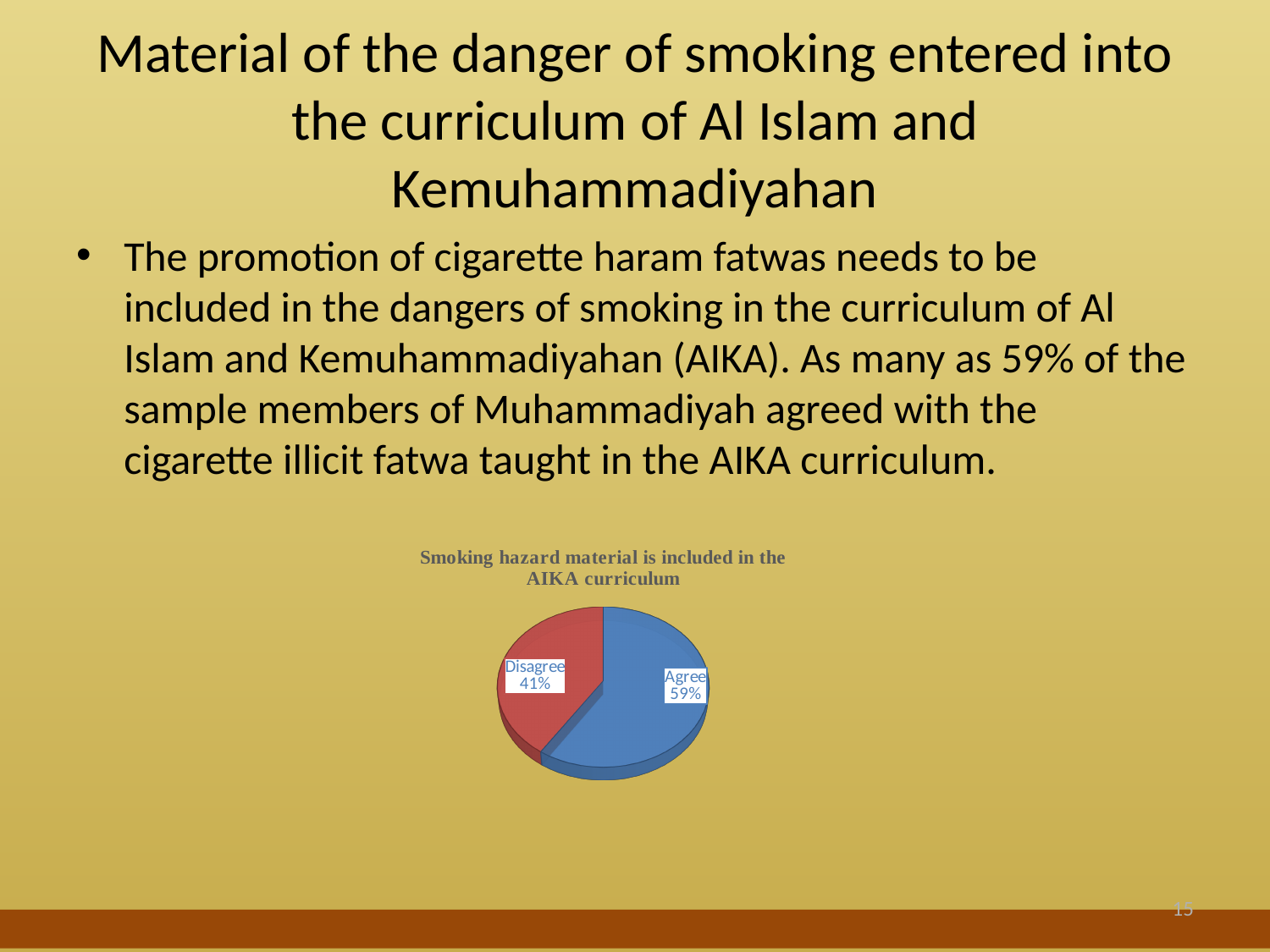
What share of the pie does Disagree represent? 41% What kind of chart is shown on the slide? Pie chart What share of the pie does Agree represent? 59% Which slice of the pie is the smallest? Disagree What is the title of the chart? Smoking hazard material is included in the AIKA curriculum Which slice of the pie is the largest? Agree What is the difference in percentage points between the Agree and Disagree slices? 18 What colour is the Agree slice? Blue Which is larger, the Agree slice or the Disagree slice? Agree How many slices does the pie chart have? 2